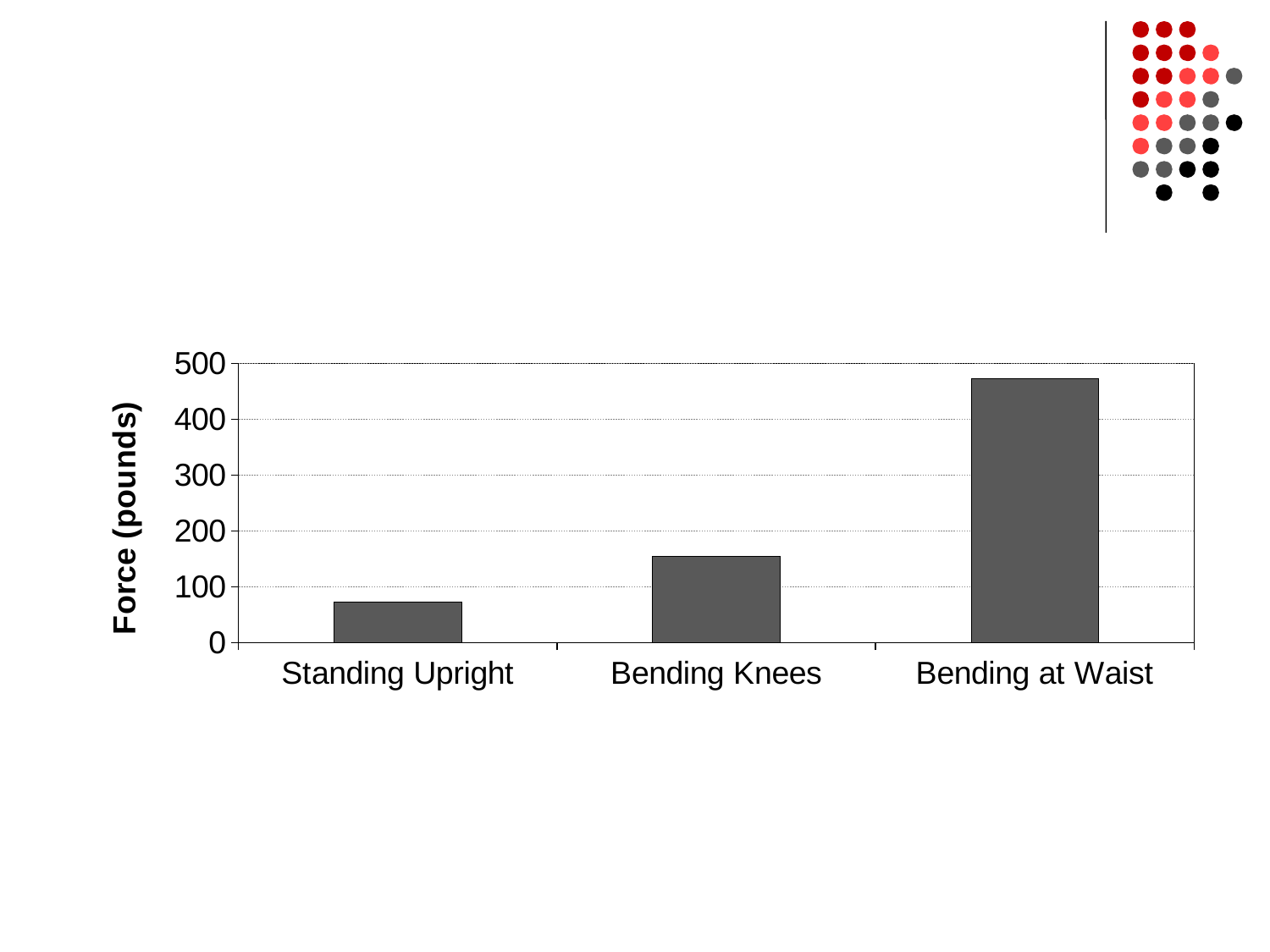
What is the label on the vertical axis of the chart? Force (pounds) Which is larger, the force for Bending Knees or for Standing Upright? Bending Knees Is the value for Bending Knees greater or less than 200? less How many categories are shown on the x axis of the chart? 3 Which category has the lowest force value? Standing Upright Which is larger, the force for Bending at Waist or for Bending Knees? Bending at Waist Do the values rise or fall moving from left to right along the x axis? rise Is the value for Bending at Waist greater or less than 400? greater Which category has the highest force value? Bending at Waist Is the value for Bending Knees greater or less than 100? greater What kind of chart is shown on the slide? bar chart